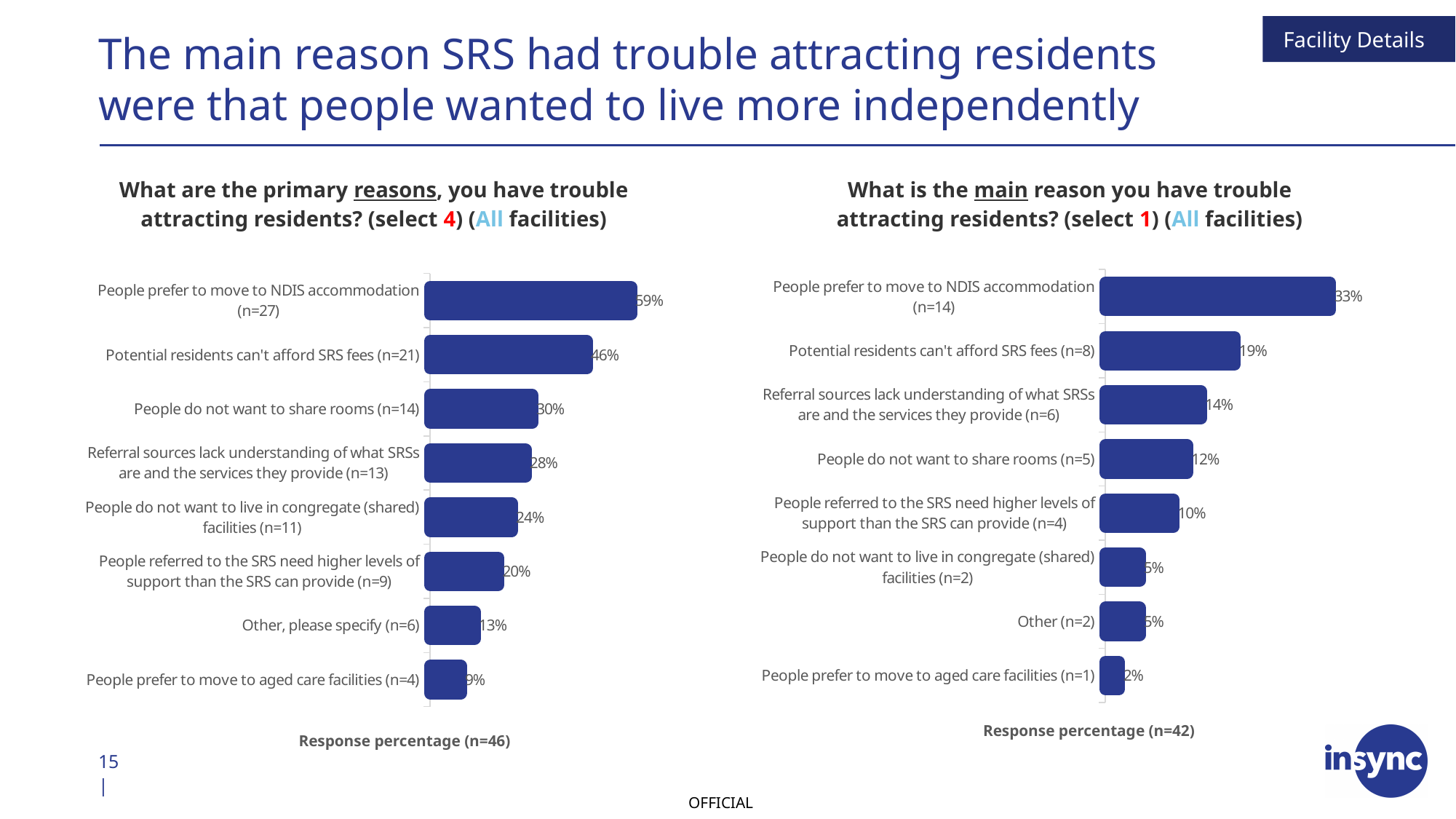
What is the total number of responses (n) stated in the axis label of the right chart (main reason, select 1)? n=42 In the right chart (main reason, select 1), what percentage is shown for 'Referral sources lack understanding of what SRSs are and the services they provide'? 14% In the left chart (primary reasons, select 4), what percentage is shown for 'Potential residents can't afford SRS fees'? 46% In the left chart (primary reasons, select 4), which is larger: the percentage for 'People do not want to live in congregate (shared) facilities' or for 'People referred to the SRS need higher levels of support than the SRS can provide'? People do not want to live in congregate (shared) facilities In the right chart (main reason, select 1), what is the difference in percentage points between 'Potential residents can't afford SRS fees' and 'People do not want to share rooms'? 7 In the left chart (primary reasons, select 4), what is the difference in percentage points between 'People do not want to share rooms' and 'Other, please specify'? 17 What type of chart is used on the left side of the slide? Bar chart In the right chart (main reason, select 1), what percentage is shown for 'People prefer to move to aged care facilities'? 2% How many reasons (bars) are shown in the right chart (main reason, select 1)? 8 In the left chart (primary reasons, select 4), what percentage is shown for 'People do not want to share rooms'? 30% In the right chart (main reason, select 1), which reason has the lowest response percentage? People prefer to move to aged care facilities In the left chart (primary reasons, select 4), which reason has the highest response percentage? People prefer to move to NDIS accommodation